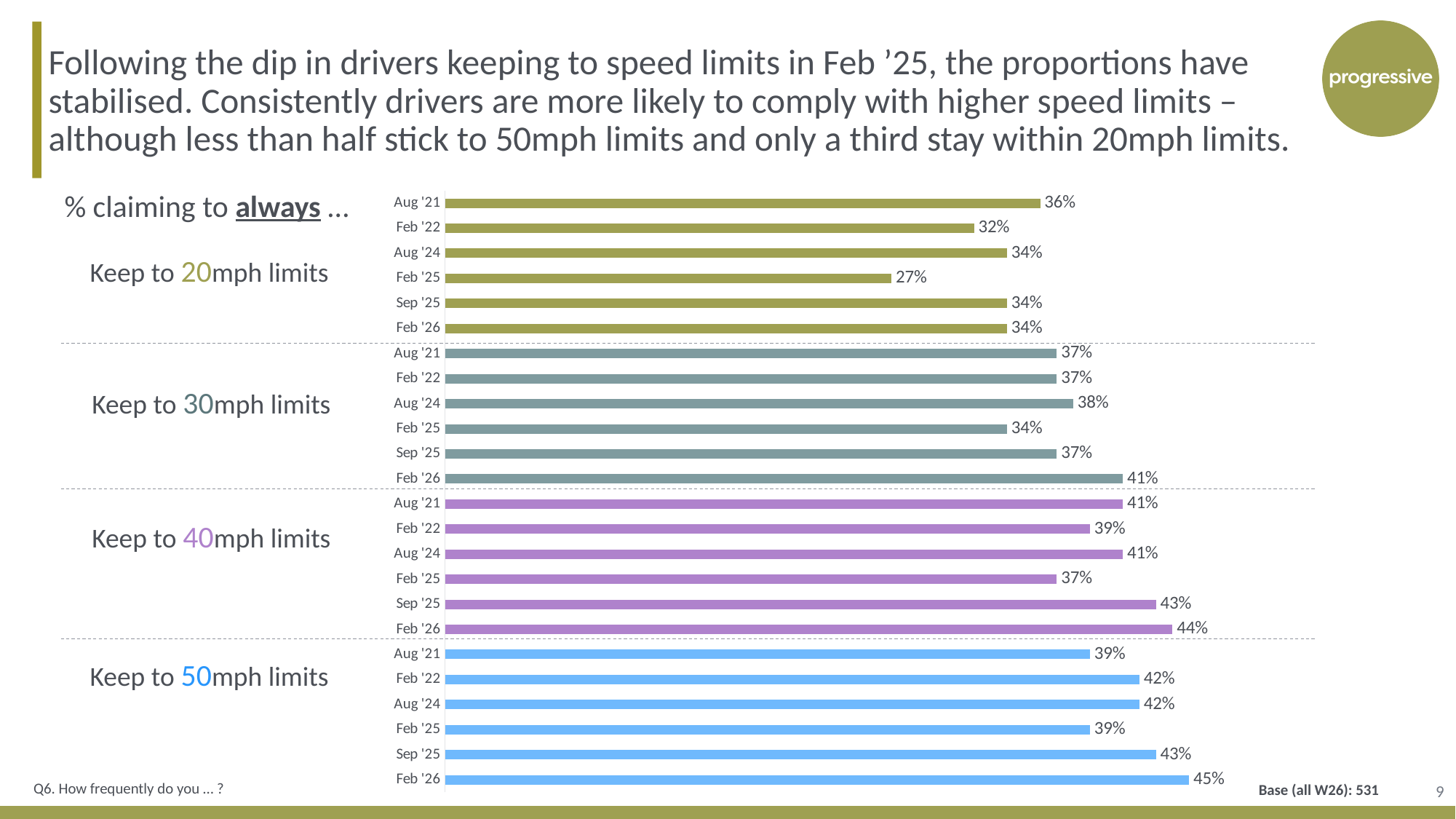
Within the 'Keep to 40mph limits' group, which wave has the highest value? Feb '26 How many time points (waves) are shown for each speed limit group? 6 What type of chart is used on this slide? Bar chart What percentage of drivers claimed to always keep to 50mph limits in Feb '26? 45% How many speed limit groups are shown in the chart? 4 What percentage of drivers claimed to always keep to 20mph limits in Feb '25? 27% What is the difference between the Feb '26 and Feb '25 values for keeping to 30mph limits? 7 percentage points What colour are the bars for the 'Keep to 50mph limits' group? Blue Within the 'Keep to 20mph limits' group, which wave has the lowest value? Feb '25 Which is larger: the Sep '25 value for 40mph limits or the Sep '25 value for 20mph limits? 40mph limits (43%) Did the value for keeping to 50mph limits rise or fall from Feb '25 to Feb '26? Rise What percentage of drivers claimed to always keep to 30mph limits in Aug '24? 38%